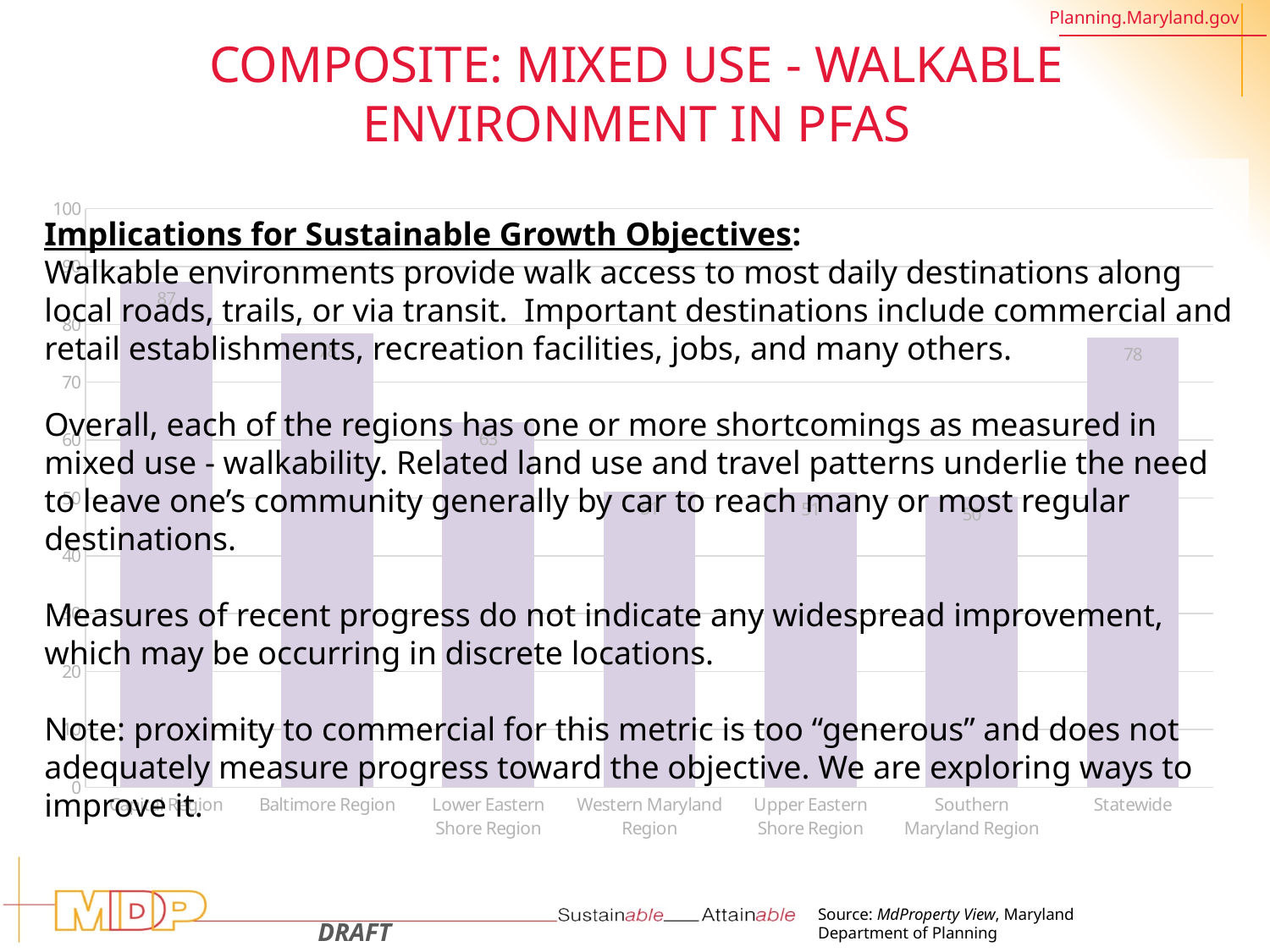
What is the value for the Upper Eastern Shore Region? 51 What is the Statewide value? 78 Is the value for the Western Maryland Region greater or less than 60? less What is the value for the Southern Maryland Region? 50 Which is larger, the Lower Eastern Shore Region value or the Southern Maryland Region value? Lower Eastern Shore Region Is the value for the Baltimore Region greater or less than 70? greater What kind of chart is shown on the slide? bar chart Which is larger, the Statewide value or the Lower Eastern Shore Region value? Statewide What is the difference between the Statewide value and the Lower Eastern Shore Region value? 15 What is the value for the Lower Eastern Shore Region? 63 How many bars are shown in the chart? 7 What is the difference between the Lower Eastern Shore Region value and the Southern Maryland Region value? 13